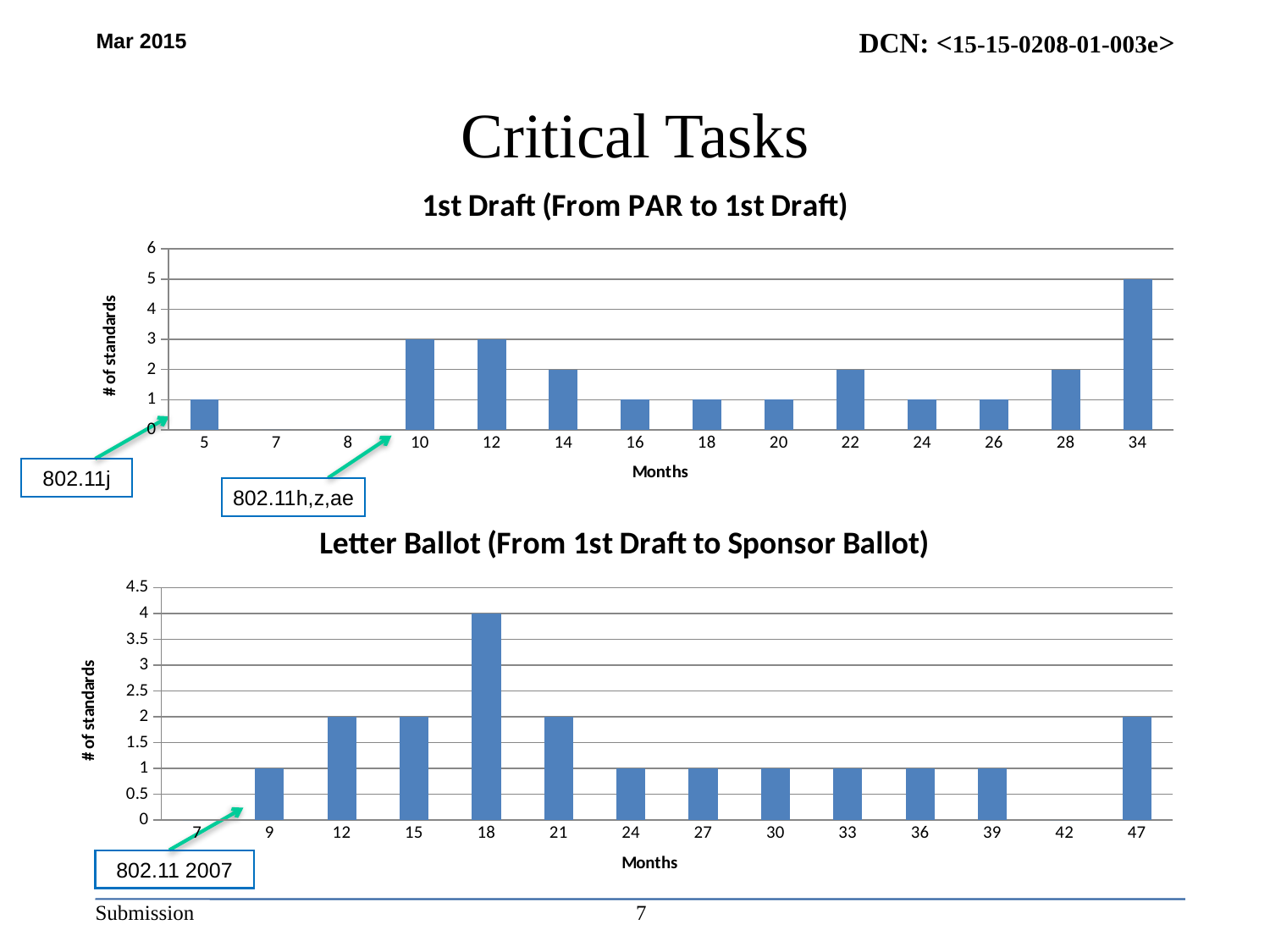
In the '1st Draft (From PAR to 1st Draft)' chart, what is the number of standards at 10 months? 3 In the '1st Draft (From PAR to 1st Draft)' chart, which month category has the highest number of standards? 34 What is the x-axis label of the '1st Draft (From PAR to 1st Draft)' chart? Months What type of chart is the 'Letter Ballot (From 1st Draft to Sponsor Ballot)' chart? Bar chart In the '1st Draft (From PAR to 1st Draft)' chart, what is the number of standards at 34 months? 5 In the 'Letter Ballot (From 1st Draft to Sponsor Ballot)' chart, what is the number of standards at 47 months? 2 In the 'Letter Ballot (From 1st Draft to Sponsor Ballot)' chart, what is the number of standards at 18 months? 4 In the 'Letter Ballot (From 1st Draft to Sponsor Ballot)' chart, which month category has the highest number of standards? 18 In the '1st Draft (From PAR to 1st Draft)' chart, how many month categories are shown on the x axis? 14 In the 'Letter Ballot (From 1st Draft to Sponsor Ballot)' chart, which is larger: the number of standards at 12 months or at 24 months? 12 months In the 'Letter Ballot (From 1st Draft to Sponsor Ballot)' chart, what is the difference between the number of standards at 18 months and at 9 months? 3 In the '1st Draft (From PAR to 1st Draft)' chart, what is the difference between the number of standards at 34 months and at 14 months? 3